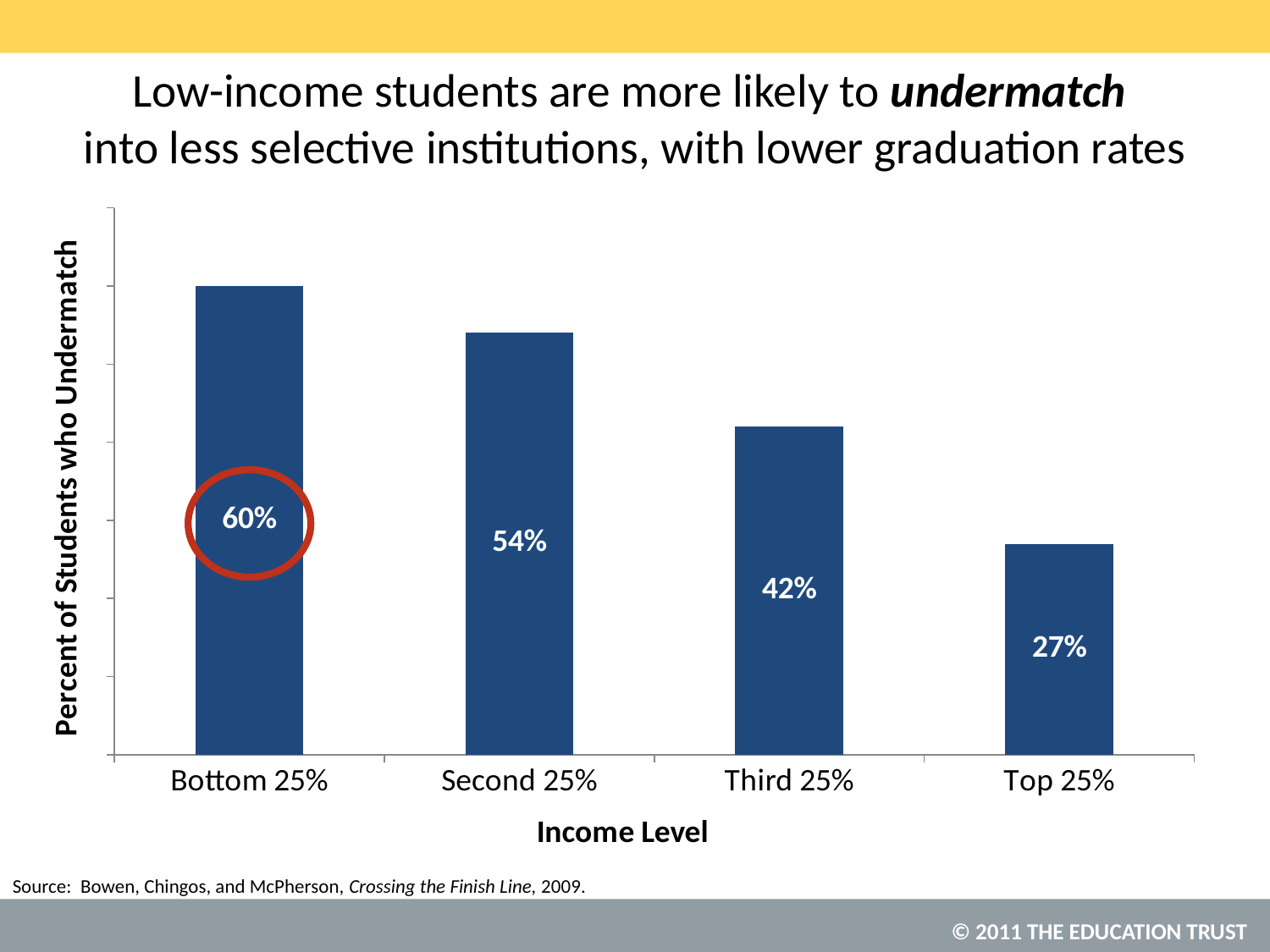
Which income level has the highest percent of students who undermatch? Bottom 25% What is the difference in undermatch percentage between the Second 25% and the Third 25% income levels? 12% What percent of students in the Third 25% income level undermatch? 42% How many income levels are shown on the chart? 4 What percent of students in the Top 25% income level undermatch? 27% Which has a higher undermatch percentage, the Second 25% or the Third 25% income level? Second 25% What percent of students in the Bottom 25% income level undermatch? 60% What kind of chart is shown on the slide? Bar chart What percent of students in the Second 25% income level undermatch? 54% What is the difference in undermatch percentage between the Bottom 25% and the Top 25% income levels? 33% Which income level has the lowest percent of students who undermatch? Top 25% Do the undermatch percentages rise or fall as income level increases from Bottom 25% to Top 25%? Fall